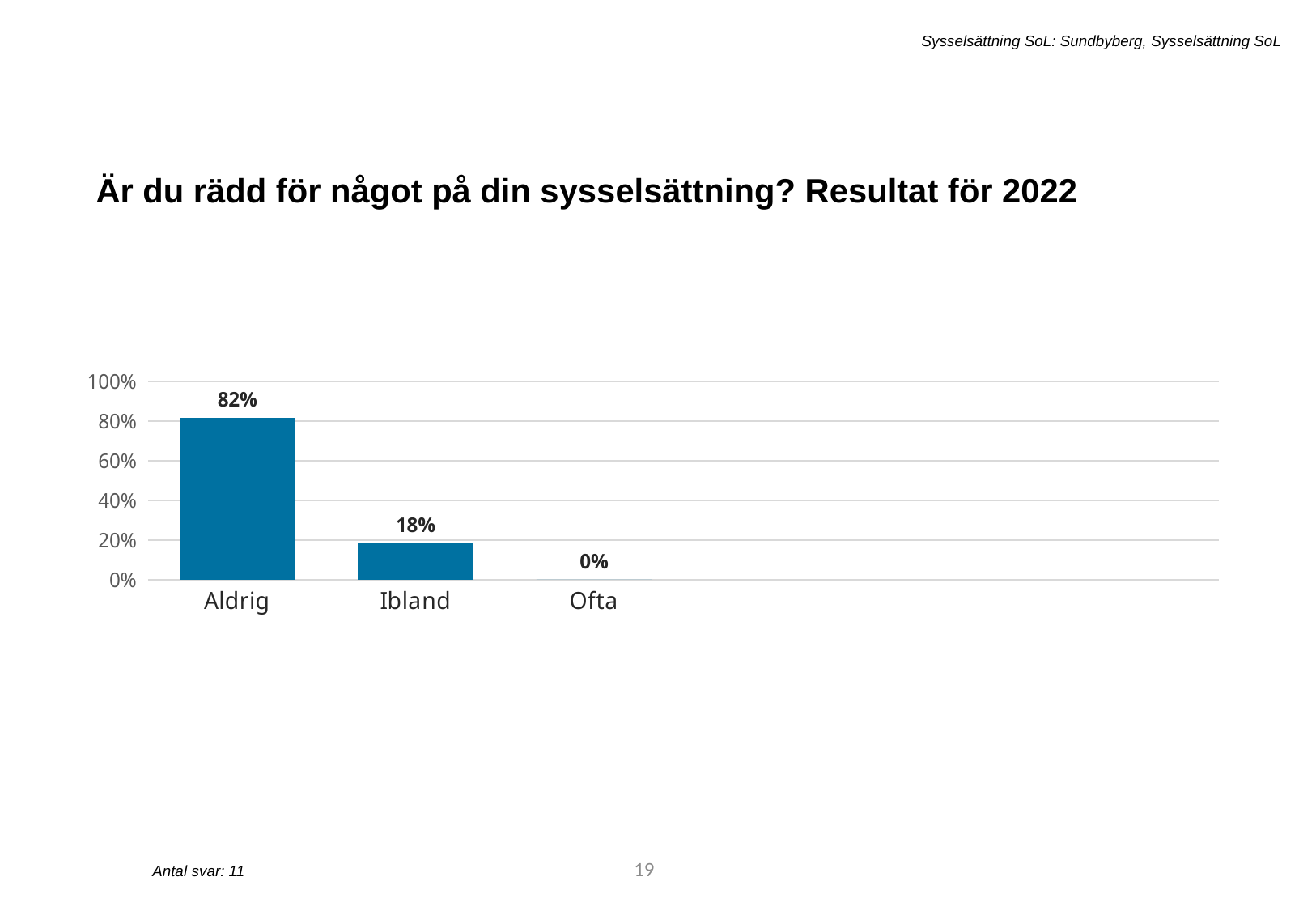
What is the value for Ibland? 18% Which category has the lowest value? Ofta What kind of chart is shown on the slide? bar chart Which category has the highest value? Aldrig What is the value for Aldrig? 82% Do the values rise or fall from left to right along the x axis? fall What is the value for Ofta? 0% What is the title of the chart on the slide? Är du rädd för något på din sysselsättning? Resultat för 2022 How many categories are shown on the x axis? 3 What is the difference between the values for Aldrig and Ibland? 64% Which is larger, the value for Ibland or the value for Ofta? Ibland Is the value for Aldrig greater or less than 60%? greater